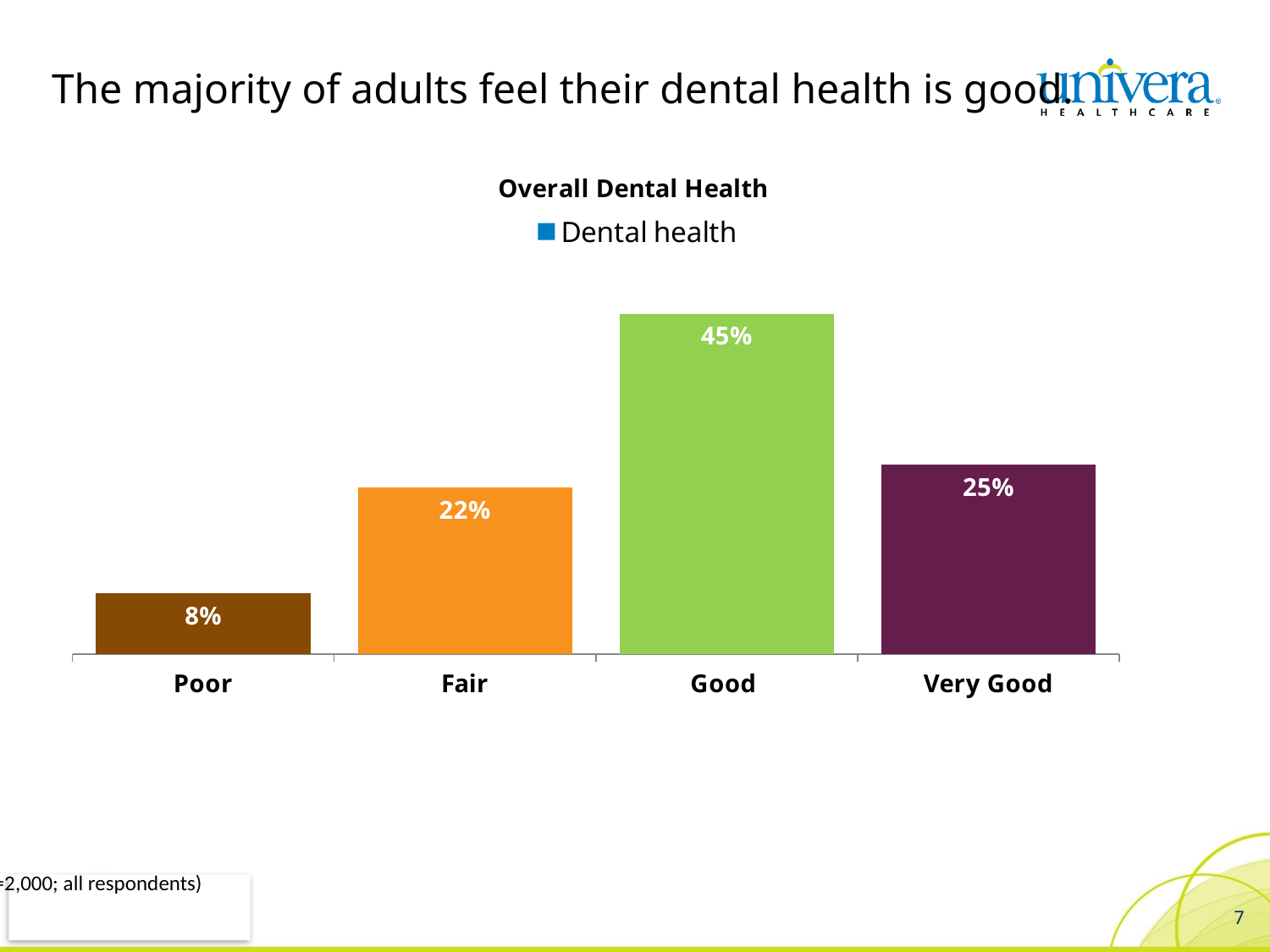
Which category has the lowest value? Poor Which is larger, the value for Fair or the value for Very Good? Very Good Which category has the highest value? Good What percentage of adults rate their dental health as Good? 45% What is the value for the Poor category? 8% What is the difference between the Fair and Poor values? 14% How many categories are shown on the x axis? 4 What kind of chart is shown on the slide? Bar chart What is the value for the Very Good category? 25% What is the value for the Fair category? 22% What is the title of the chart? Overall Dental Health What is the difference between the Good and Very Good values? 20%